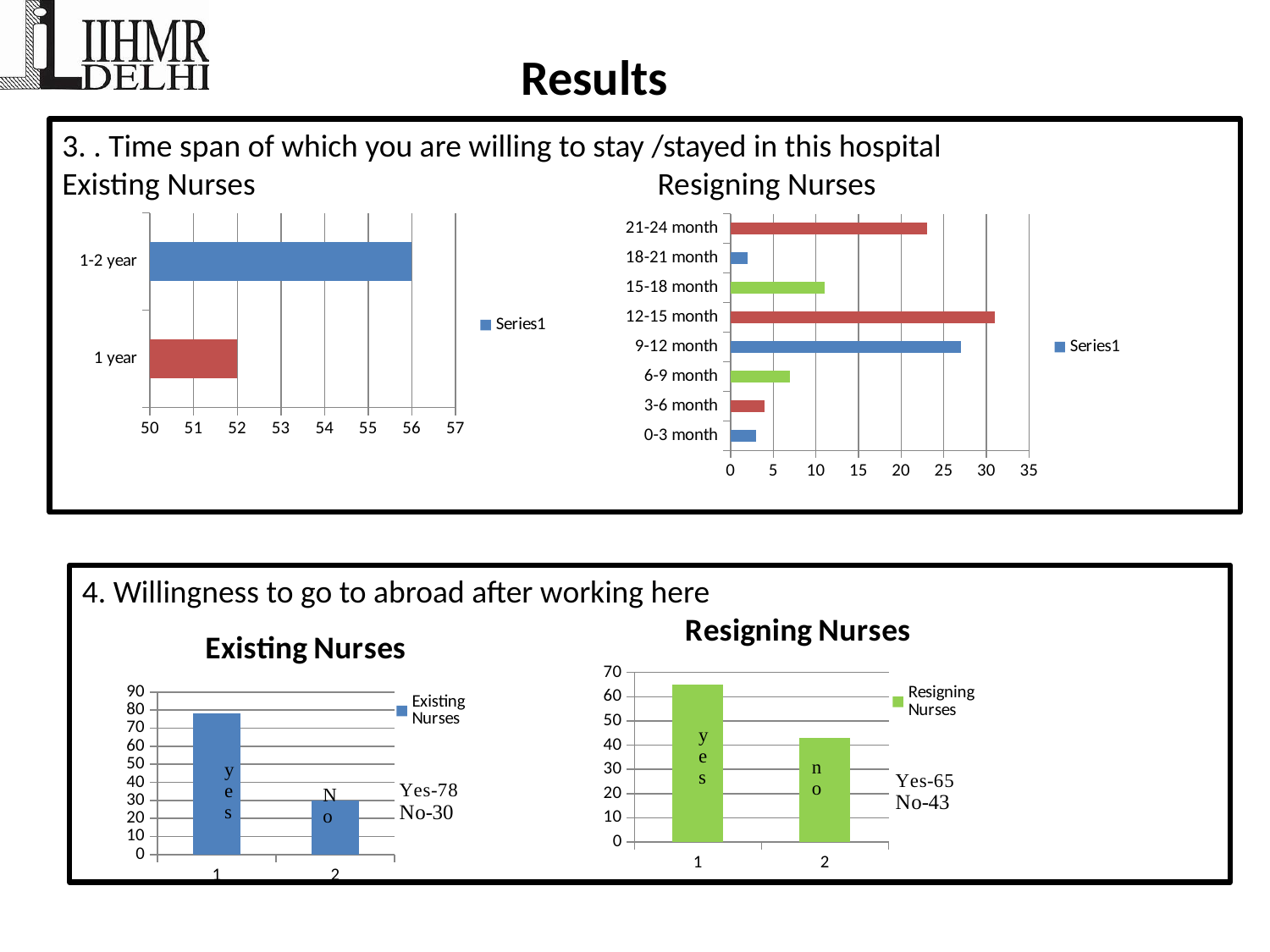
In the 'Existing Nurses' chart under question 3, is the value for '1-2 year' greater or less than 55? greater In the 'Resigning Nurses' chart under question 4, what is the value for 'no'? 43 In the 'Resigning Nurses' chart under question 3, what is the legend entry? Series1 In the 'Existing Nurses' chart under question 3, what type of chart is shown? bar chart In the 'Existing Nurses' chart under question 3, which category has the higher value, '1-2 year' or '1 year'? 1-2 year In the 'Resigning Nurses' chart under question 3, which category has the highest value? 12-15 month In the 'Existing Nurses' chart under question 3, is the value for '1 year' greater or less than 53? less In the 'Existing Nurses' chart under question 4, what is the value for 'yes'? 78 In the 'Existing Nurses' chart under question 4, what is the difference between the 'yes' and 'no' values? 48 In the 'Resigning Nurses' chart under question 3, which is larger, the value for '9-12 month' or '15-18 month'? 9-12 month In the 'Resigning Nurses' chart under question 3, how many categories are plotted? 8 In the 'Resigning Nurses' chart under question 3, is the value for '21-24 month' greater or less than 20? greater